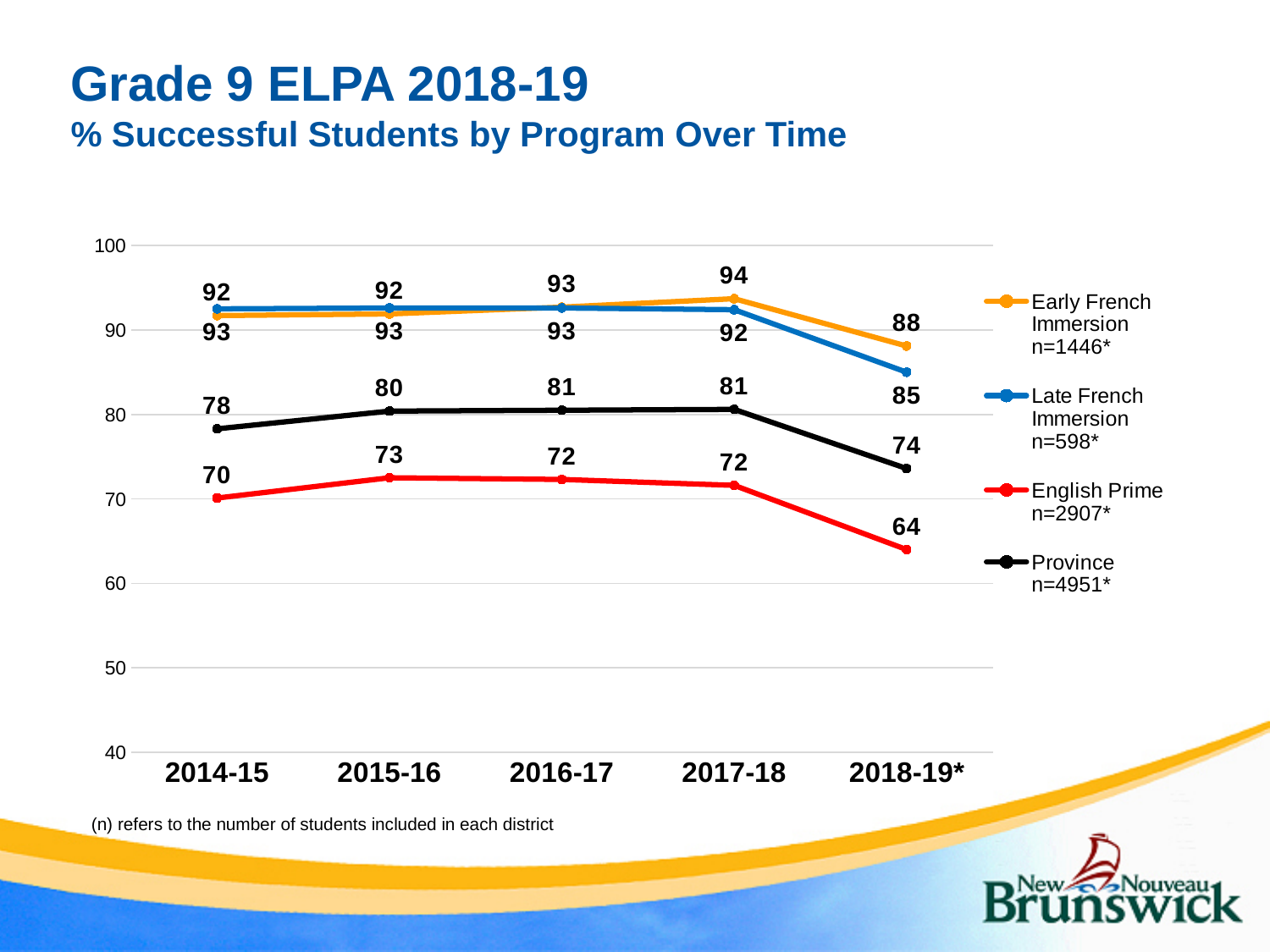
What kind of chart is shown on the slide? Line chart In which year does English Prime have its lowest value? 2018-19* Does the English Prime line rise or fall from 2017-18 to 2018-19*? Fall In which year does Early French Immersion reach its highest value? 2017-18 What is the value for Province in 2018-19*? 74 How many years are shown on the x axis? 5 What is the value for Late French Immersion in 2018-19*? 85 By how much did the Province value drop from 2017-18 to 2018-19*? 7 How many series does the legend list? 4 What is the value for Early French Immersion in 2017-18? 94 What is the value for English Prime in 2014-15? 70 In 2018-19*, which is larger: English Prime or Province? Province